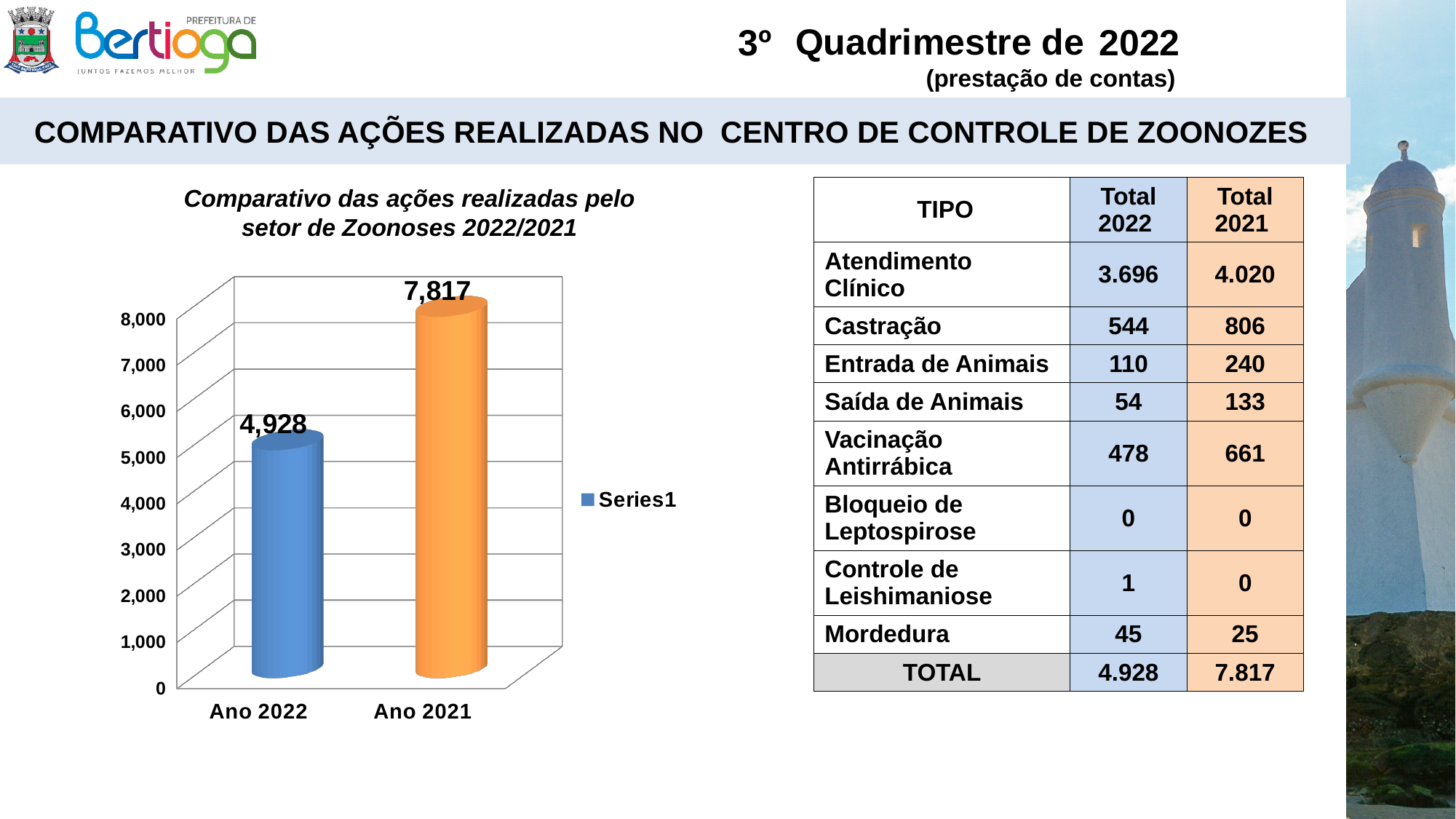
What is the difference between the values for Ano 2021 and Ano 2022? 2,889 What kind of chart is shown on the slide? bar chart How many categories are shown on the x axis of the chart? 2 How many series does the chart legend list? 1 Which category has the highest value in the chart? Ano 2021 What is the value for Ano 2021 in the chart? 7,817 Is the value for Ano 2021 greater or less than 8,000? less Is the value for Ano 2022 greater or less than 4,000? greater What is the title of the chart? Comparativo das ações realizadas pelo setor de Zoonoses 2022/2021 What is the value for Ano 2022 in the chart? 4,928 Which is larger, the value for Ano 2022 or the value for Ano 2021? Ano 2021 Which category has the lowest value in the chart? Ano 2022